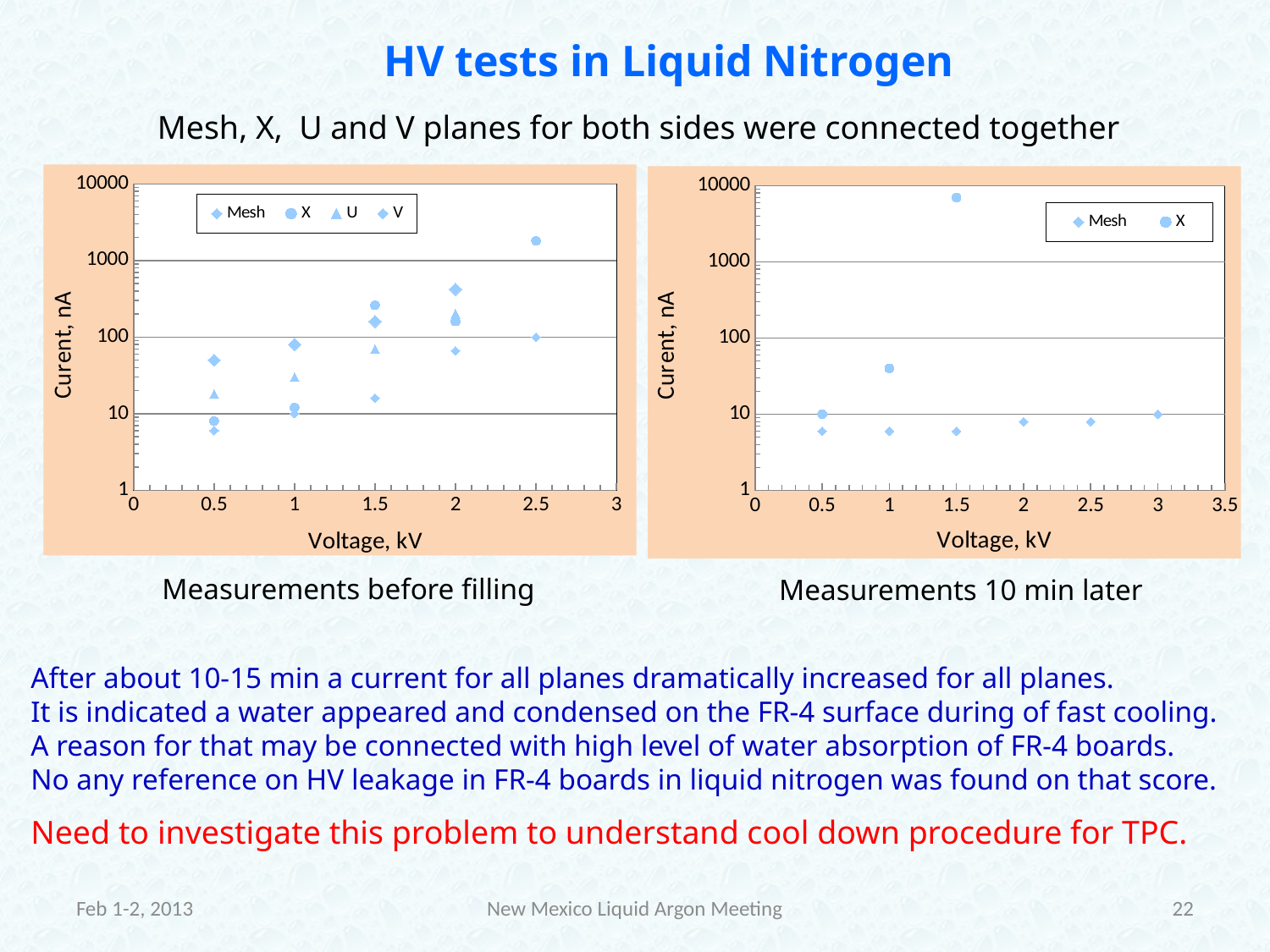
In the right chart (Measurements 10 min later), is the Mesh value at 3 kV greater or less than 100? less In the right chart (Measurements 10 min later), is the X value at 1 kV greater or less than 10? greater In the left chart (Measurements before filling), how many series does the legend list? 4 In the left chart (Measurements before filling), is the X value at 2.5 kV greater or less than 1000? greater In the right chart (Measurements 10 min later), how many X data points are plotted? 3 In the left chart (Measurements before filling), what is the y-axis title? Curent, nA In the right chart (Measurements 10 min later), how many series does the legend list? 2 What kind of chart is the left chart (Measurements before filling)? Scatter chart In the right chart (Measurements 10 min later), does the X current rise or fall as voltage increases? rises In the left chart (Measurements before filling), at 2.5 kV, which series has the larger current, X or Mesh? X In the right chart (Measurements 10 min later), what is the x-axis title? Voltage, kV